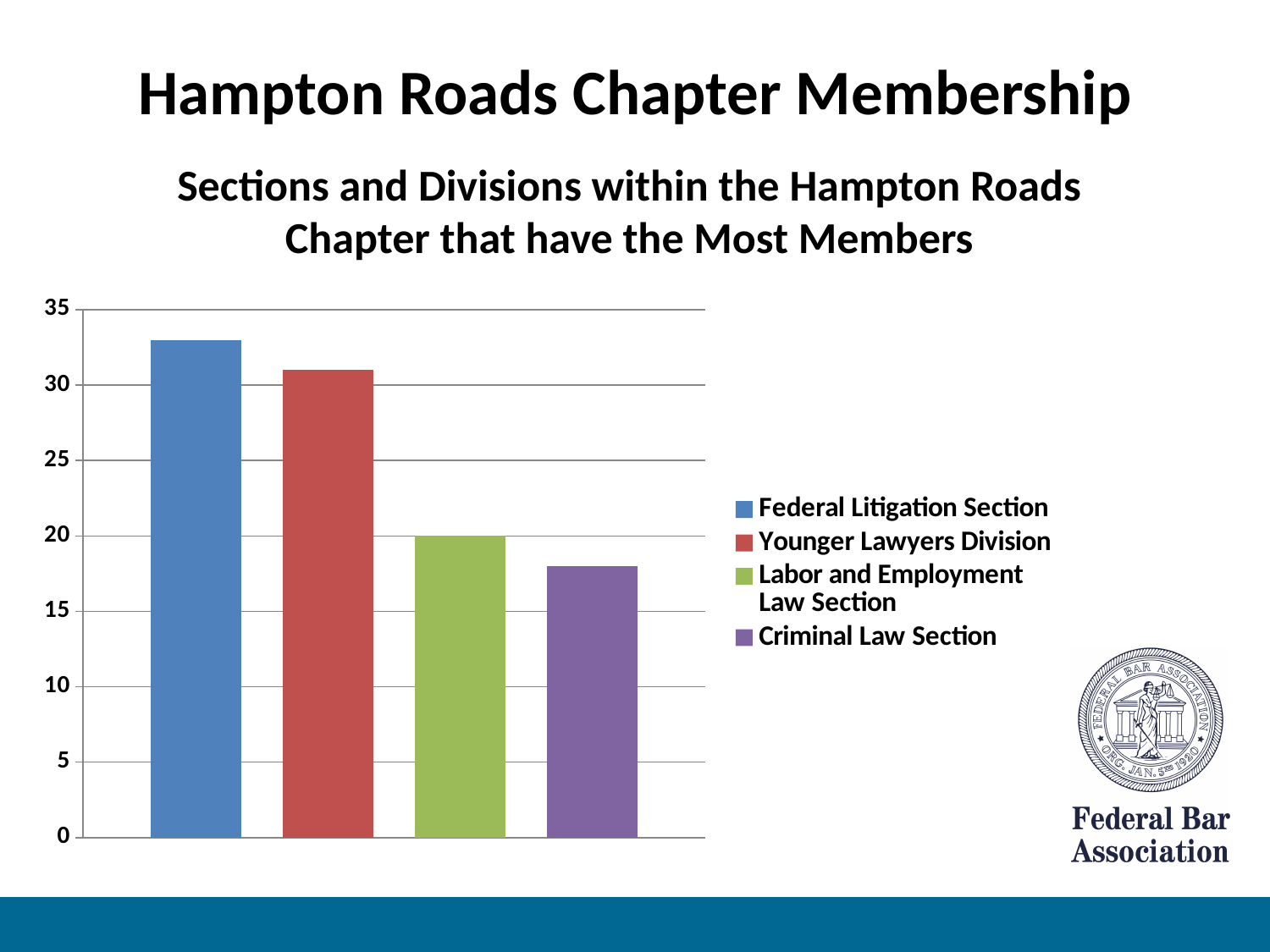
Is the value for the Younger Lawyers Division greater or less than 35? less How many entries does the legend list? 4 How many bars are plotted in the chart? 4 Which section or division has the lowest membership in the chart? Criminal Law Section What kind of chart is shown on the slide? bar chart Which section or division has the highest membership in the chart? Federal Litigation Section What colour is the bar for the Criminal Law Section? purple Do the bar values rise or fall from left to right across the chart? fall Is the value for the Labor and Employment Law Section greater or less than 15? greater Is the value for the Criminal Law Section greater or less than 20? less Which has more members, the Younger Lawyers Division or the Labor and Employment Law Section? Younger Lawyers Division